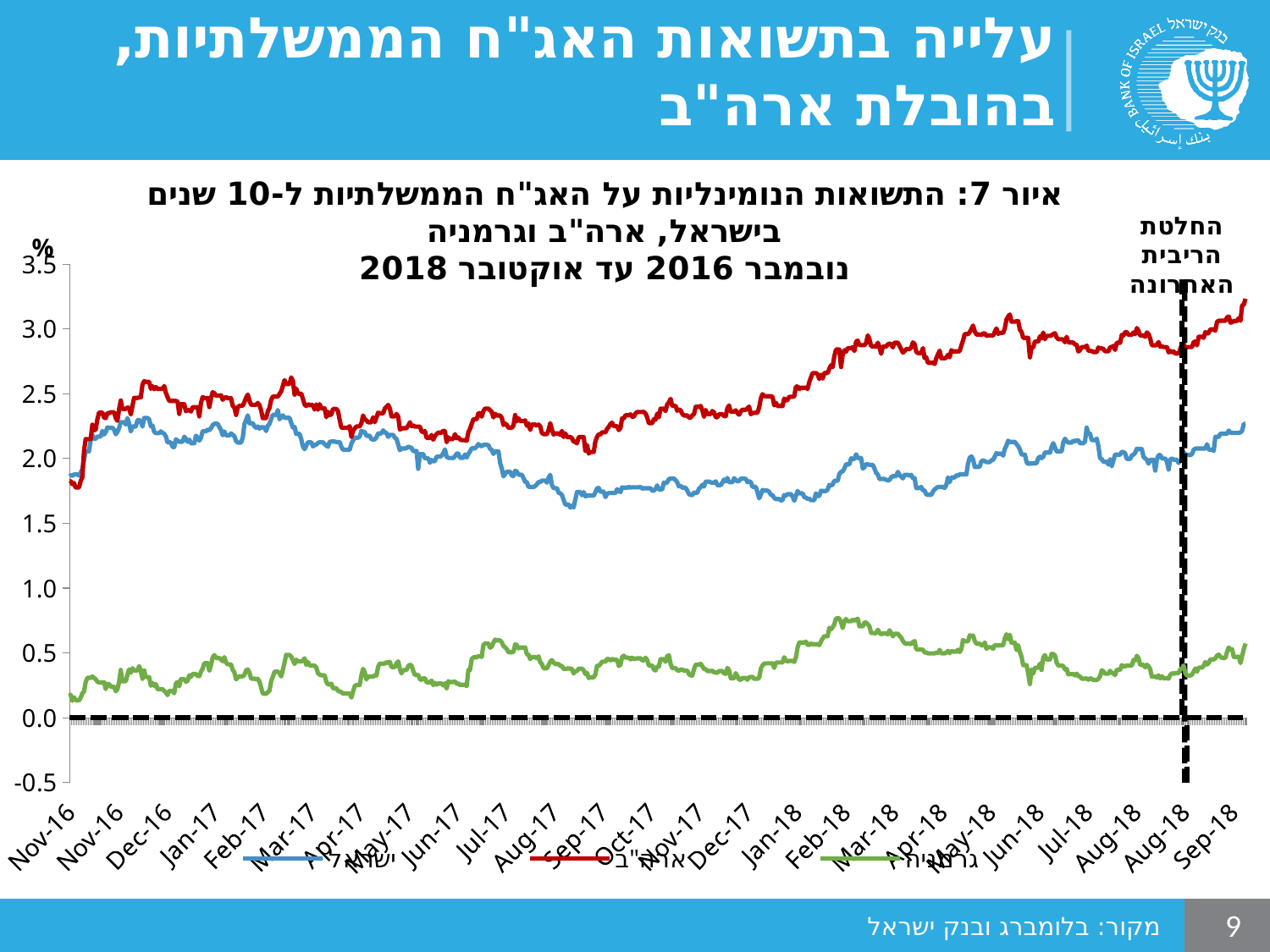
Around Sep-17, is the value for ישראל greater or less than 2.0? less Which series has the highest value at the end of the period (Sep-18)? ארה"ב Which series has the lowest values throughout the chart? גרמניה At the end of the period (Sep-18), is the value for ארה"ב greater or less than 3.0? greater At Sep-18, which is larger: the value for ארה"ב or the value for ישראל? ארה"ב At the end of the period (Sep-18), is the value for ישראל greater or less than 2.0? greater Which colour is used for the ארה"ב series? red Does the ארה"ב series rise or fall overall from Nov-16 to Sep-18? rise Which three countries' series are listed in the legend? ישראל, ארה"ב, גרמניה How many series does the legend list? 3 What kind of chart is shown on the slide? line chart